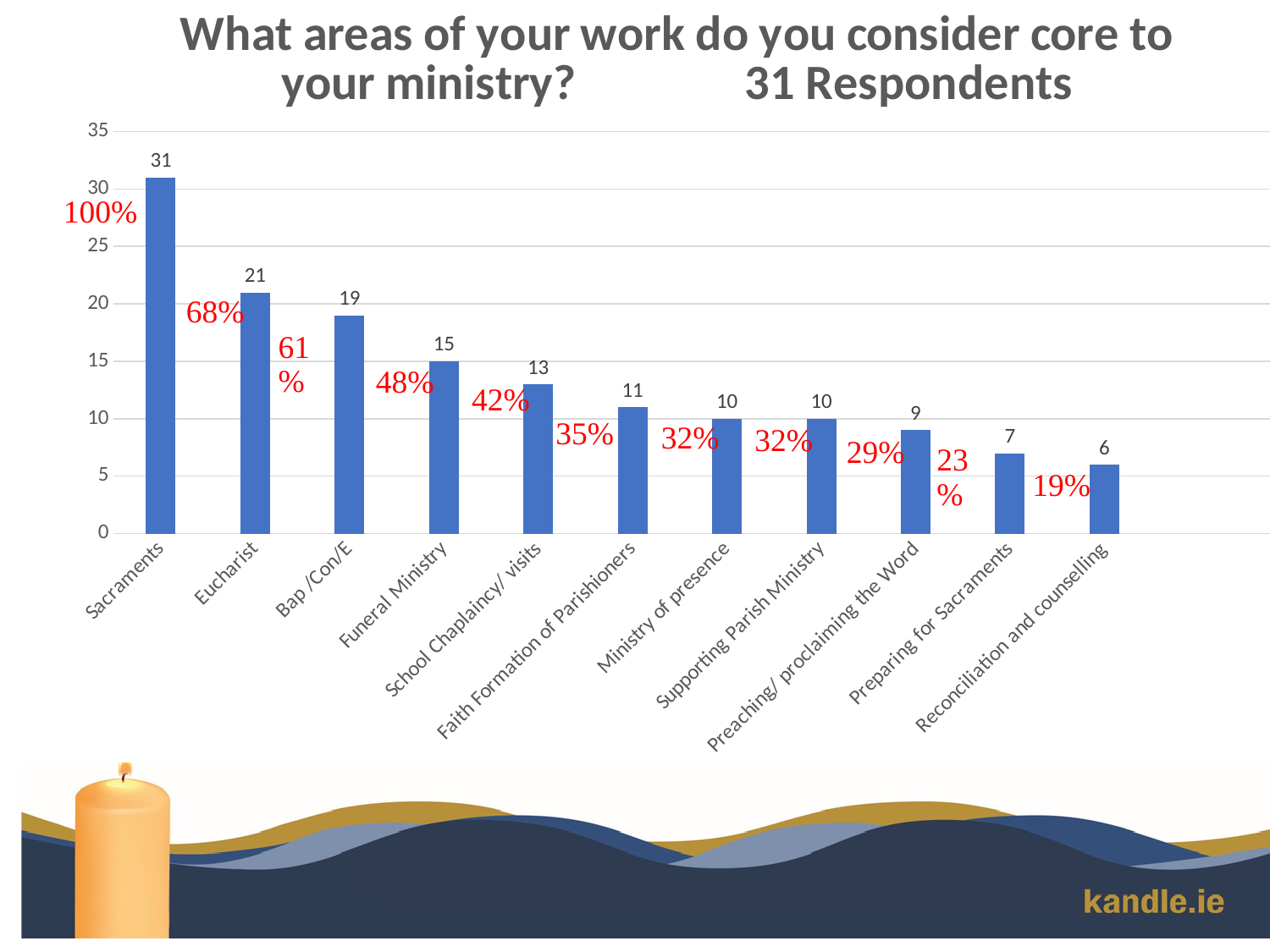
How many categories are shown on the x axis? 11 How many respondents does the chart title say there were? 31 Respondents What kind of chart is this? Bar chart Which category has the lowest value? Reconciliation and counselling Which category has the highest value? Sacraments What is the value for Funeral Ministry? 15 Which is larger, the value for School Chaplaincy/ visits or the value for Faith Formation of Parishioners? School Chaplaincy/ visits Do the values rise or fall from left to right along the x axis? Fall What is the value for Preaching/ proclaiming the Word? 9 What is the difference between the values for Eucharist and Bap /Con/E? 2 What percentage is shown in red next to the Eucharist bar? 68% What is the value for Sacraments? 31